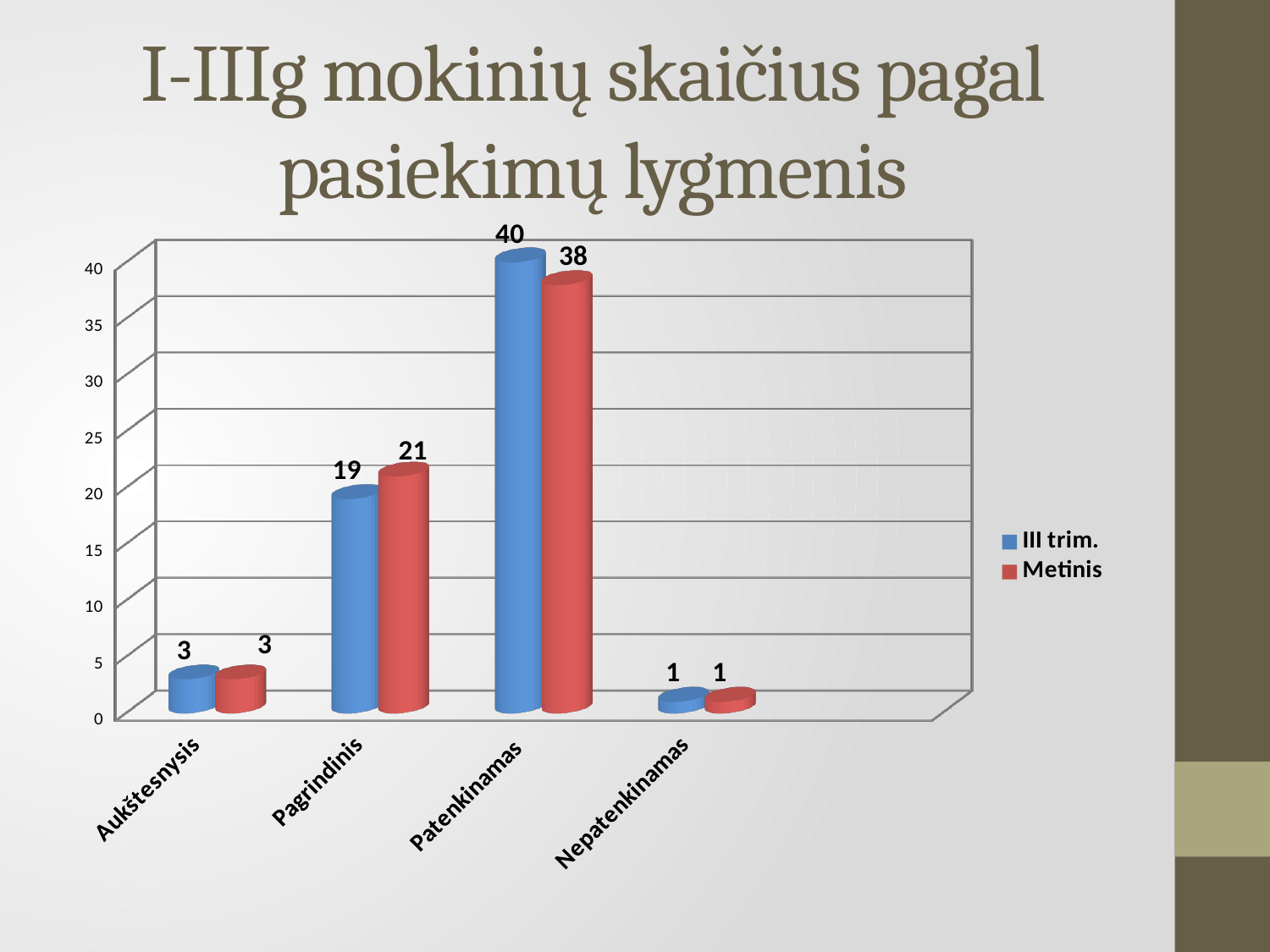
What is the value for Patenkinamas in the Metinis series? 38 Which category has the highest value in the III trim. series? Patenkinamas What is the difference between the Metinis and III trim. values for Pagrindinis? 2 What is the value for Pagrindinis in the III trim. series? 19 How many series does the legend list? 2 What is the difference between the III trim. and Metinis values for Patenkinamas? 2 Which series is shown in red? Metinis How many categories are shown on the x axis? 4 What is the value for Aukštesnysis in the Metinis series? 3 Which is larger for Pagrindinis: the III trim. value or the Metinis value? Metinis Which category has the lowest value in the Metinis series? Nepatenkinamas What kind of chart is shown on the slide? Bar chart